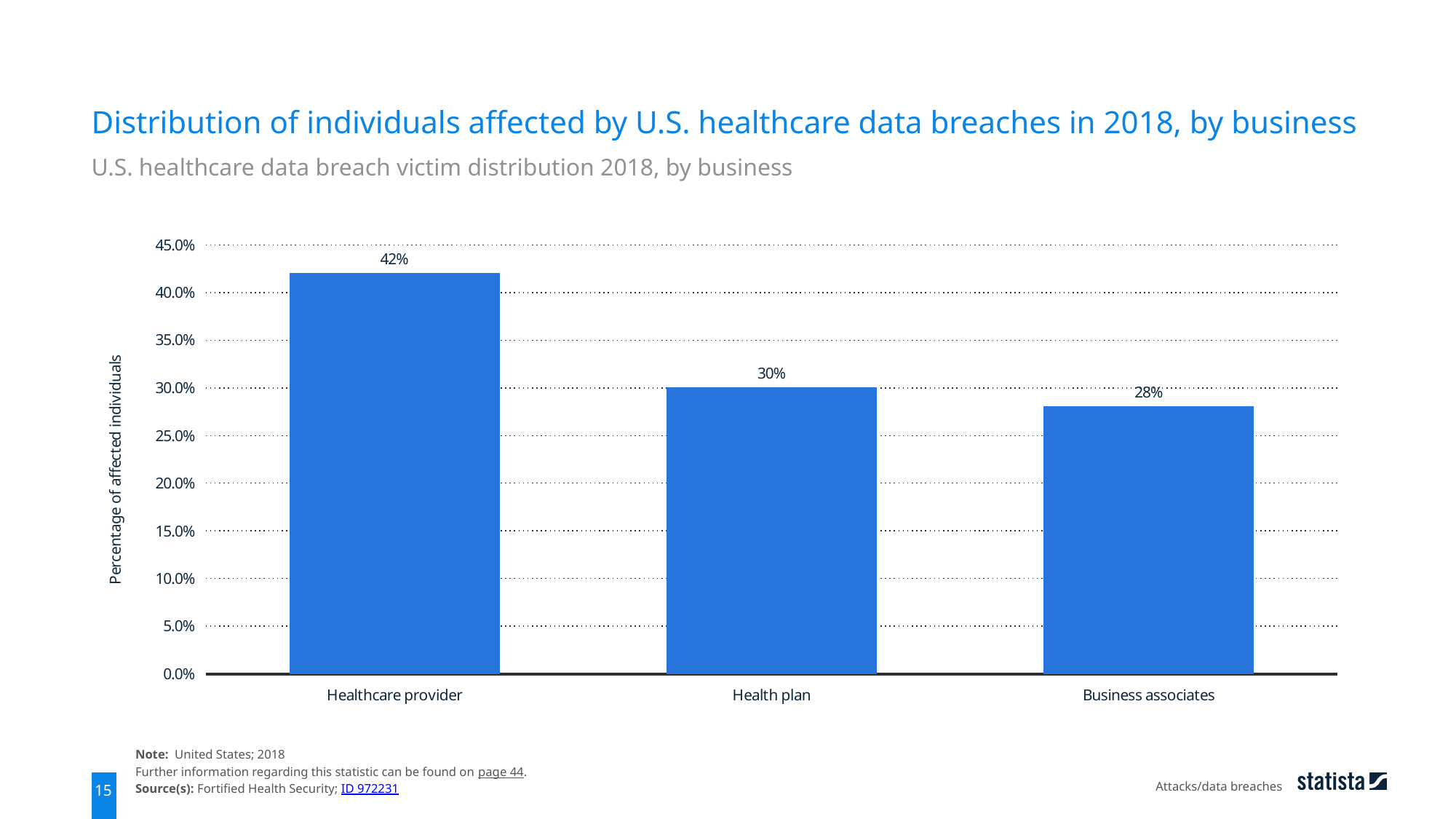
Is the value for Healthcare provider greater or less than 40.0%? greater How many business categories are shown on the chart? 3 Which has a larger share of affected individuals, Health plan or Business associates? Health plan What is the difference in percentage points between Healthcare provider and Business associates? 14 What percentage of affected individuals is shown for Business associates? 28% What is the difference in percentage points between Healthcare provider and Health plan? 12 Which business category has the lowest percentage of affected individuals? Business associates What is the label of the vertical axis? Percentage of affected individuals What percentage of affected individuals is shown for Healthcare provider? 42% What percentage of affected individuals is shown for Health plan? 30% What kind of chart is shown on the slide? Bar chart Which business category has the highest percentage of affected individuals? Healthcare provider